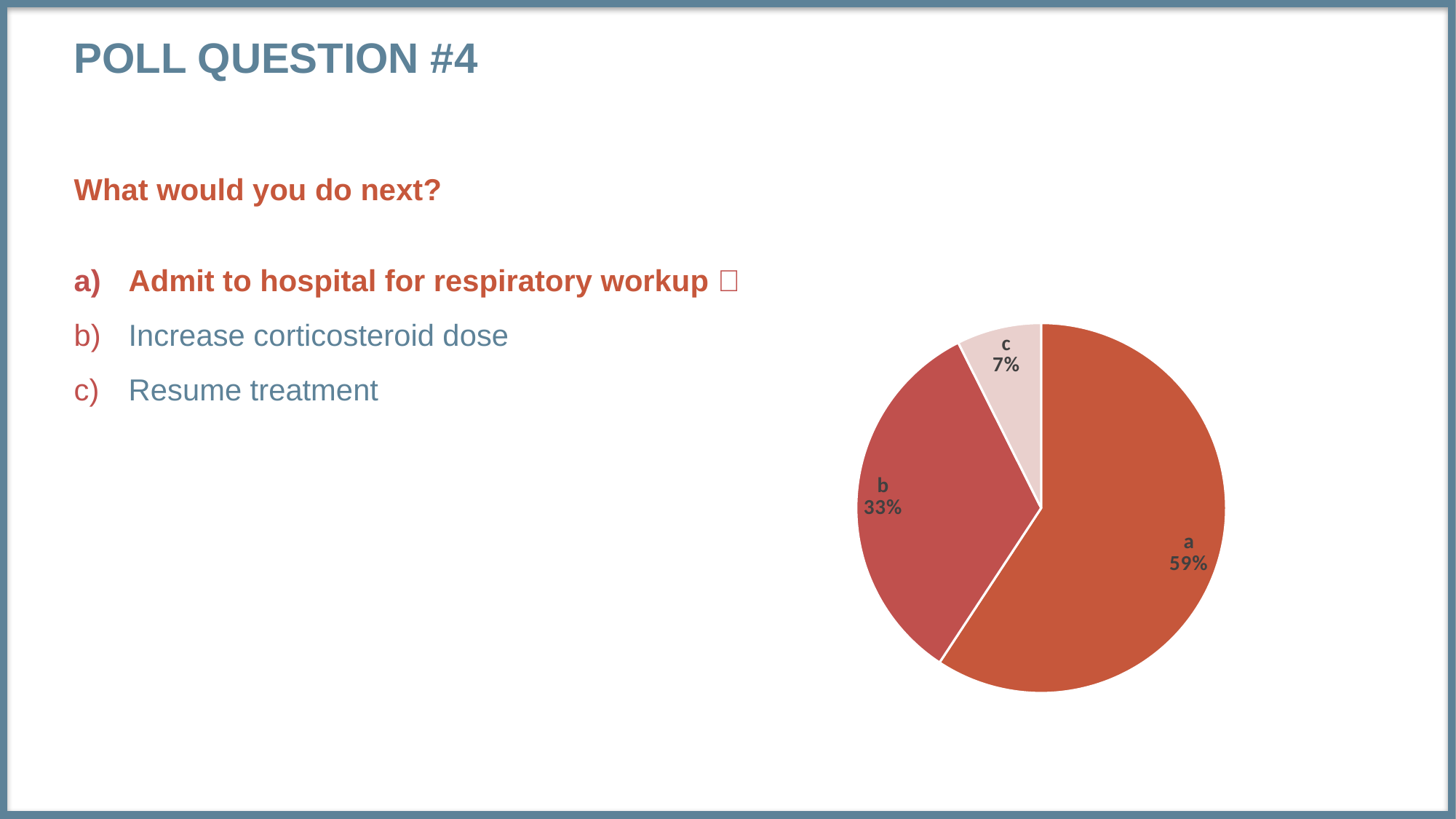
Which slice of the pie is the lightest in colour? c What share of the pie does slice b have? 33% What kind of chart is shown on the slide? pie chart What share of the pie does slice c have? 7% What is the difference in percentage points between slice b and slice c? 26 What is the difference in percentage points between slice a and slice b? 26 Which slice of the pie is the largest? a Is the share for slice a greater or less than 50%? greater How many slices does the pie chart have? 3 Which is larger, slice b or slice c? b Which slice of the pie is the smallest? c What share of the pie does slice a have? 59%